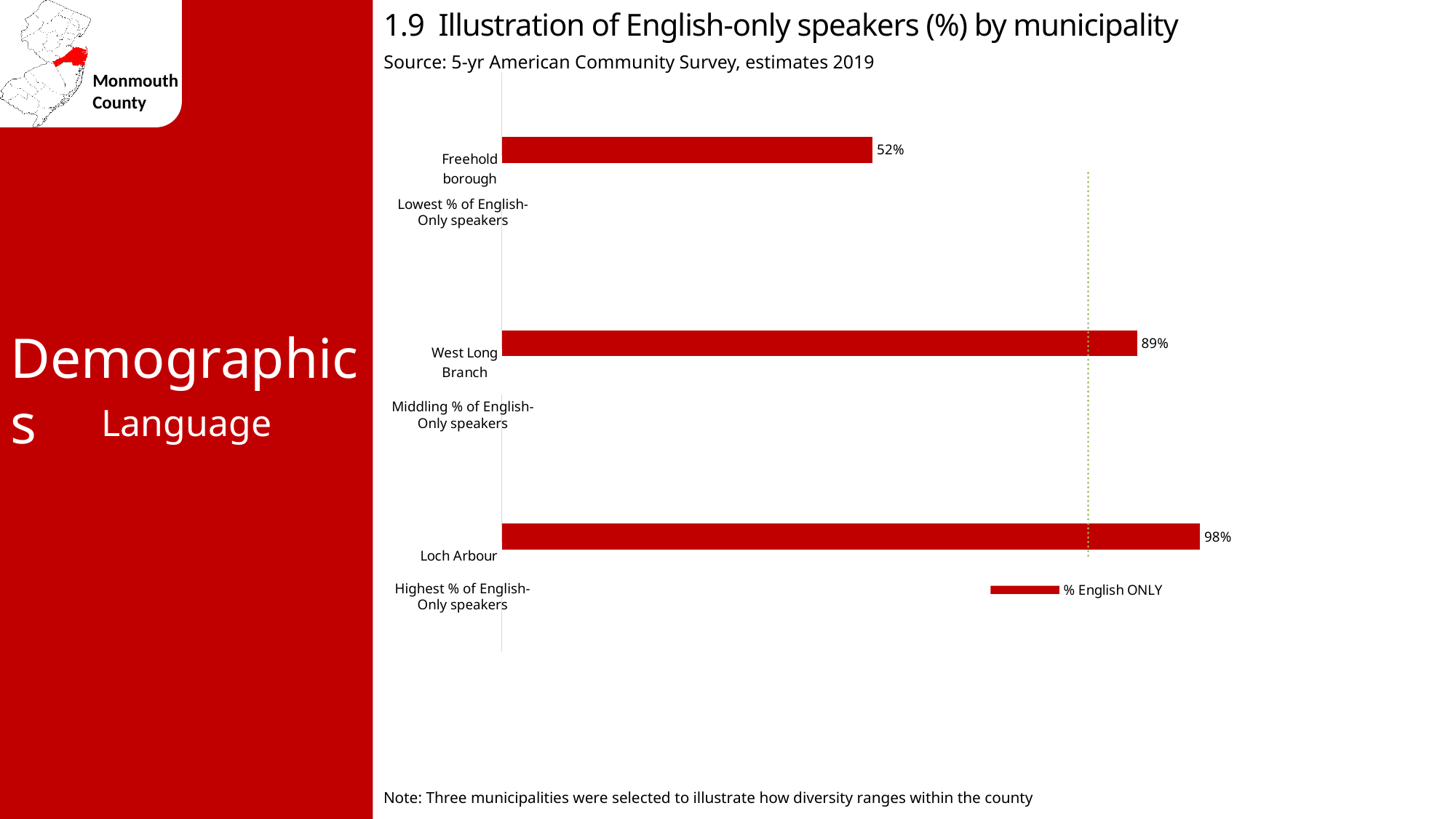
What is the percentage of English-only speakers in West Long Branch? 89% How many municipalities are shown in the chart? 3 What kind of chart is shown on the slide? Bar chart How many series does the legend list? 1 Which has a higher percentage of English-only speakers, West Long Branch or Freehold borough? West Long Branch What is the percentage of English-only speakers in Freehold borough? 52% What is the legend entry for the series in the chart? % English ONLY Which municipality has the lowest percentage of English-only speakers? Freehold borough What is the percentage of English-only speakers in Loch Arbour? 98% What is the difference in percentage points between Loch Arbour and Freehold borough? 46 What is the difference in percentage points between West Long Branch and Freehold borough? 37 Which municipality has the highest percentage of English-only speakers? Loch Arbour